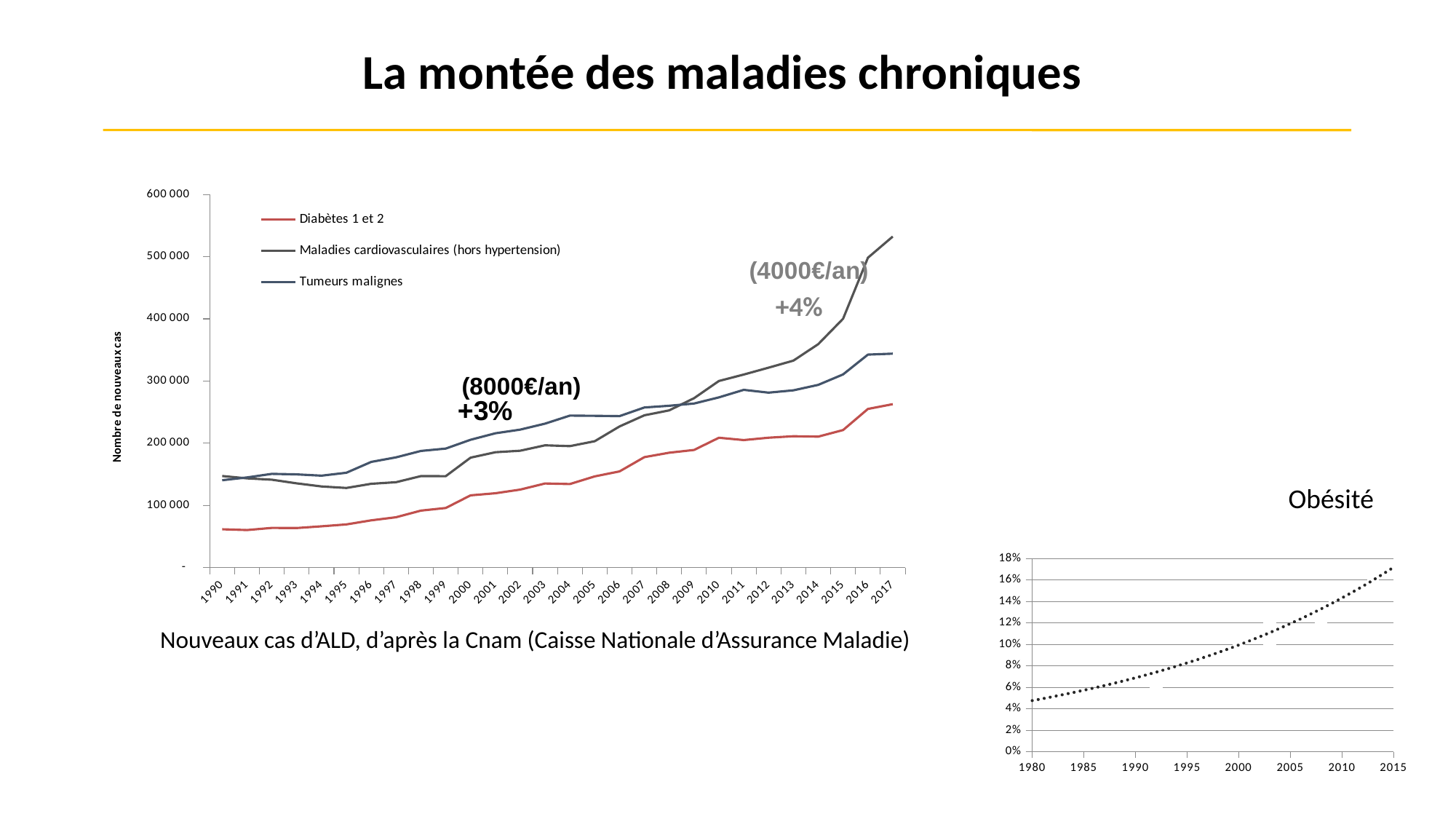
On the left chart (Nouveaux cas d'ALD), what is the label of the y axis? Nombre de nouveaux cas On the left chart (Nouveaux cas d'ALD), how many series does the legend list? 3 On the left chart (Nouveaux cas d'ALD), how many years are shown on the x axis? 28 On the left chart (Nouveaux cas d'ALD), which series has the highest value in 2017? Maladies cardiovasculaires (hors hypertension) On the left chart (Nouveaux cas d'ALD), which series has the lowest value in 2017? Diabètes 1 et 2 On the left chart (Nouveaux cas d'ALD), is the value for Diabètes 1 et 2 in 1990 greater or less than 100 000? less On the left chart (Nouveaux cas d'ALD), in 1990, which is larger: Tumeurs malignes or Diabètes 1 et 2? Tumeurs malignes On the left chart (Nouveaux cas d'ALD), what kind of chart is it? line chart On the right chart (Obésité), do the values rise or fall from 1980 to 2015? rise On the left chart (Nouveaux cas d'ALD), do the values for Diabètes 1 et 2 rise or fall from 1990 to 2017? rise On the left chart (Nouveaux cas d'ALD), is the value for Maladies cardiovasculaires (hors hypertension) in 2017 greater or less than 500 000? greater On the right chart (Obésité), is the value for 2015 greater or less than 16%? greater